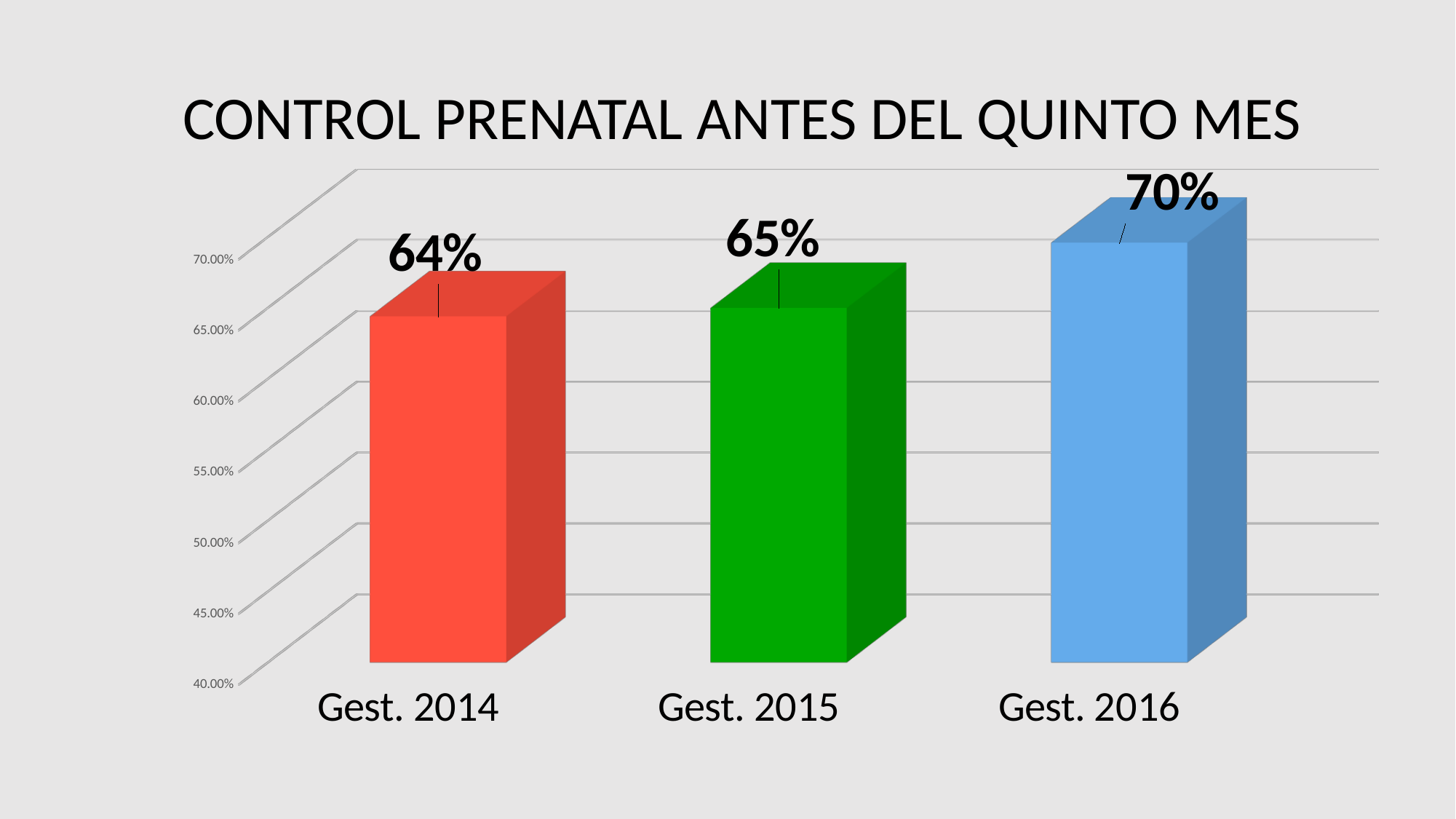
Which category has the lowest value? Gest. 2014 What is the value for Gest. 2015? 65% What is the value for Gest. 2016? 70% Is the value for Gest. 2016 greater or less than 65.00%? greater What is the difference between the values for Gest. 2016 and Gest. 2014? 6% How many categories are shown on the chart? 3 Do the values rise or fall from Gest. 2014 to Gest. 2016? Rise What kind of chart is shown on the slide? Bar chart What is the value for Gest. 2014? 64% What is the difference between the values for Gest. 2015 and Gest. 2014? 1% Which is larger, the value for Gest. 2016 or the value for Gest. 2015? Gest. 2016 Which category has the highest value? Gest. 2016